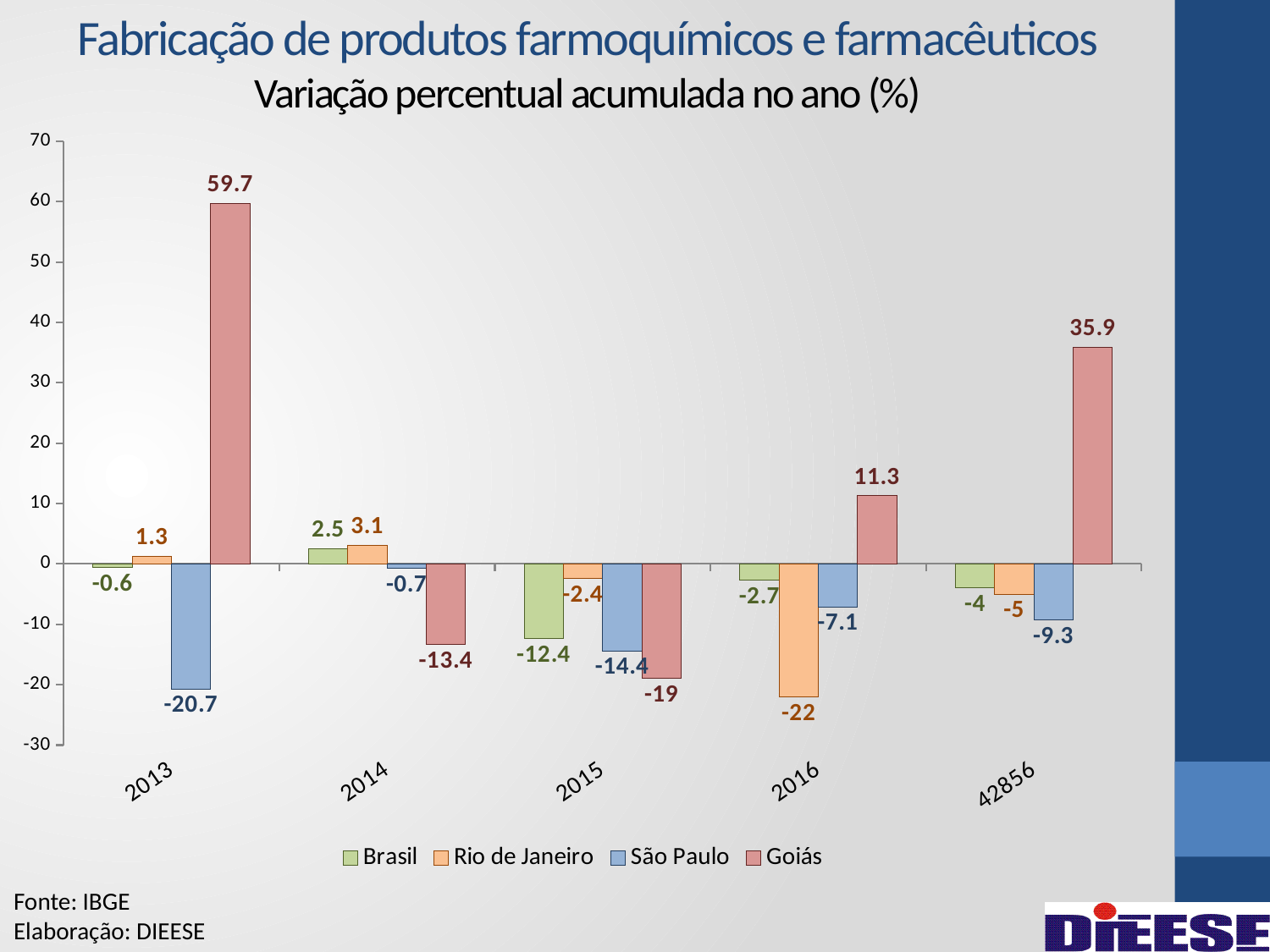
What is the difference between the Goiás values in 2013 and 2016? 48.4 What is the value for Goiás in the category labelled 42856? 35.9 What is the value for Goiás in 2013? 59.7 What is the value for São Paulo in 2013? -20.7 What is the value for Brasil in 2015? -12.4 Which is larger, the São Paulo value in 2015 or the São Paulo value in 2016? São Paulo in 2016 Which series has the highest value in 2014? Rio de Janeiro Which series has the lowest value in 2015? Goiás What kind of chart is shown on the slide? Bar chart How many series does the legend list? 4 How many categories are shown on the x axis? 5 What is the value for Rio de Janeiro in 2016? -22